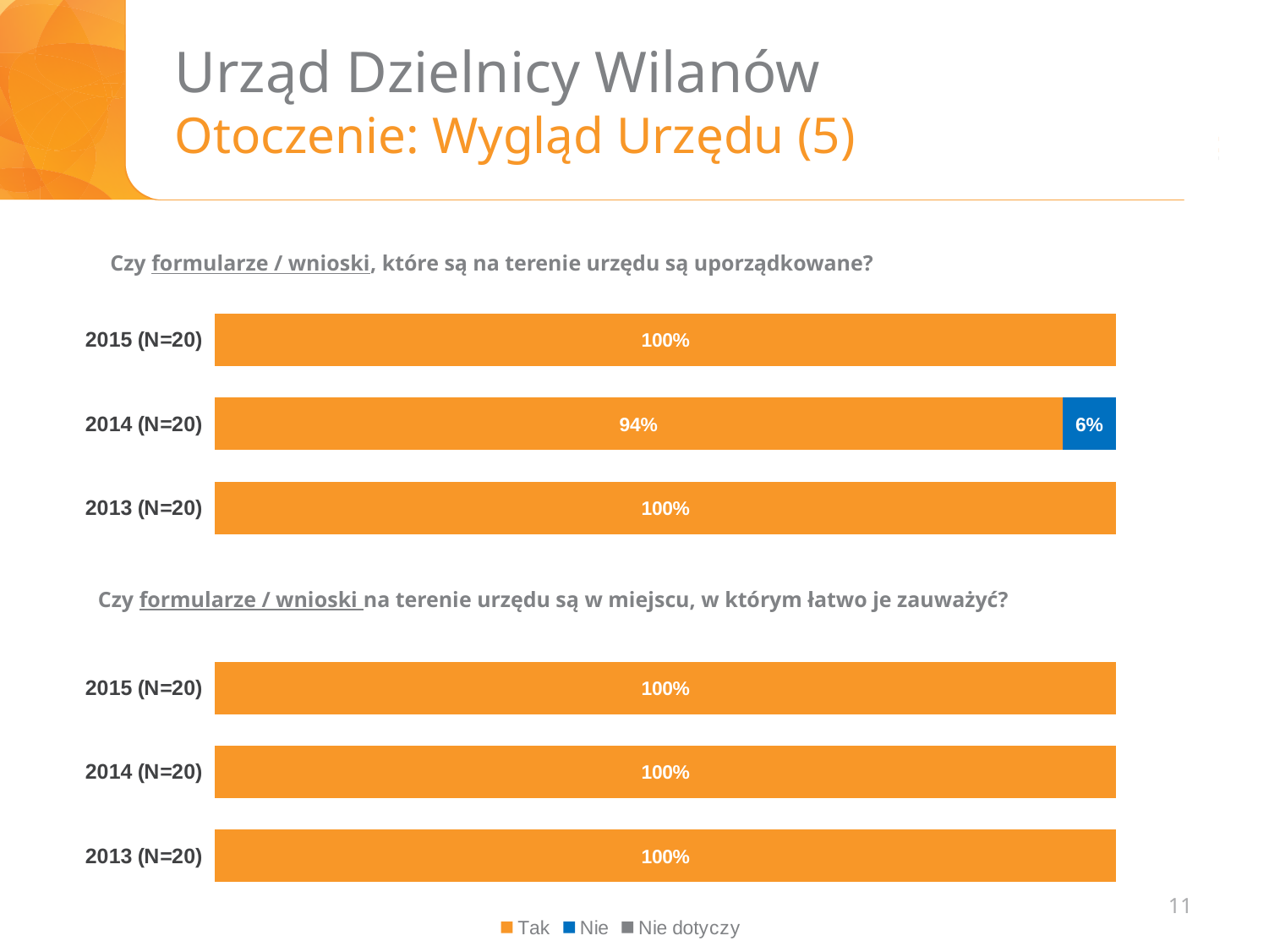
In the top chart ("Czy formularze / wnioski, które są na terenie urzędu są uporządkowane?"), what is the difference between the "Tak" values for 2015 (N=20) and 2014 (N=20)? 6% How many series does the legend at the bottom of the slide list? 3 What kind of chart is the top chart ("Czy formularze / wnioski, które są na terenie urzędu są uporządkowane?")? Stacked bar chart In the top chart ("Czy formularze / wnioski, które są na terenie urzędu są uporządkowane?"), is the "Tak" value for 2014 (N=20) larger or smaller than the "Tak" value for 2013 (N=20)? Smaller In the top chart ("Czy formularze / wnioski, które są na terenie urzędu są uporządkowane?"), what is the "Nie" value for 2014 (N=20)? 6% In the top chart ("Czy formularze / wnioski, które są na terenie urzędu są uporządkowane?"), what is the "Tak" value for 2014 (N=20)? 94% Which series in the legend at the bottom of the slide is shown in blue? Nie In the top chart ("Czy formularze / wnioski, które są na terenie urzędu są uporządkowane?"), what is the "Tak" value for 2015 (N=20)? 100% In the bottom chart ("Czy formularze / wnioski na terenie urzędu są w miejscu, w którym łatwo je zauważyć?"), what is the "Tak" value for 2013 (N=20)? 100% In the top chart ("Czy formularze / wnioski, które są na terenie urzędu są uporządkowane?"), what is the total of the 2014 (N=20) bar? 100% In the top chart ("Czy formularze / wnioski, które są na terenie urzędu są uporządkowane?"), which year has the lowest "Tak" value? 2014 (N=20) In the bottom chart ("Czy formularze / wnioski na terenie urzędu są w miejscu, w którym łatwo je zauważyć?"), how many year categories are shown? 3